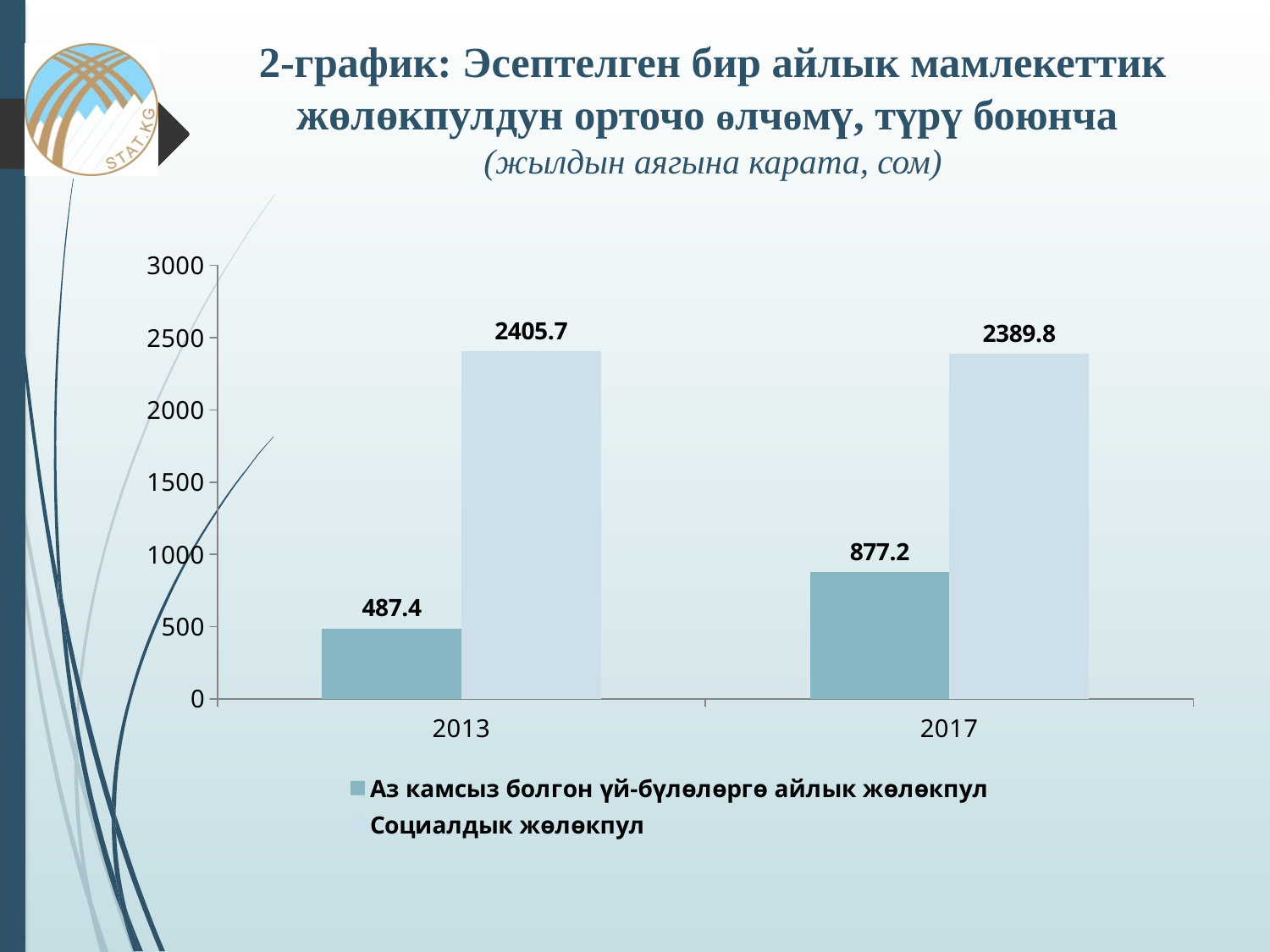
How many years are shown on the x axis? 2 What is the value for Социалдык жөлөкпул in 2017? 2389.8 What kind of chart is shown on the slide? bar chart Is the value for Социалдык жөлөкпул in 2013 larger or smaller than in 2017? larger What is the difference between the 2017 and 2013 values for Аз камсыз болгон үй-бүлөлөргө айлык жөлөкпул? 389.8 Which year has the lower value for Социалдык жөлөкпул? 2017 What is the value for Аз камсыз болгон үй-бүлөлөргө айлык жөлөкпул in 2017? 877.2 What is the value for Аз камсыз болгон үй-бүлөлөргө айлык жөлөкпул in 2013? 487.4 Which year has the higher value for Аз камсыз болгон үй-бүлөлөргө айлык жөлөкпул? 2017 How many series does the legend list? 2 What is the difference between the Социалдык жөлөкпул and Аз камсыз болгон үй-бүлөлөргө айлык жөлөкпул values in 2013? 1918.3 What is the value for Социалдык жөлөкпул in 2013? 2405.7